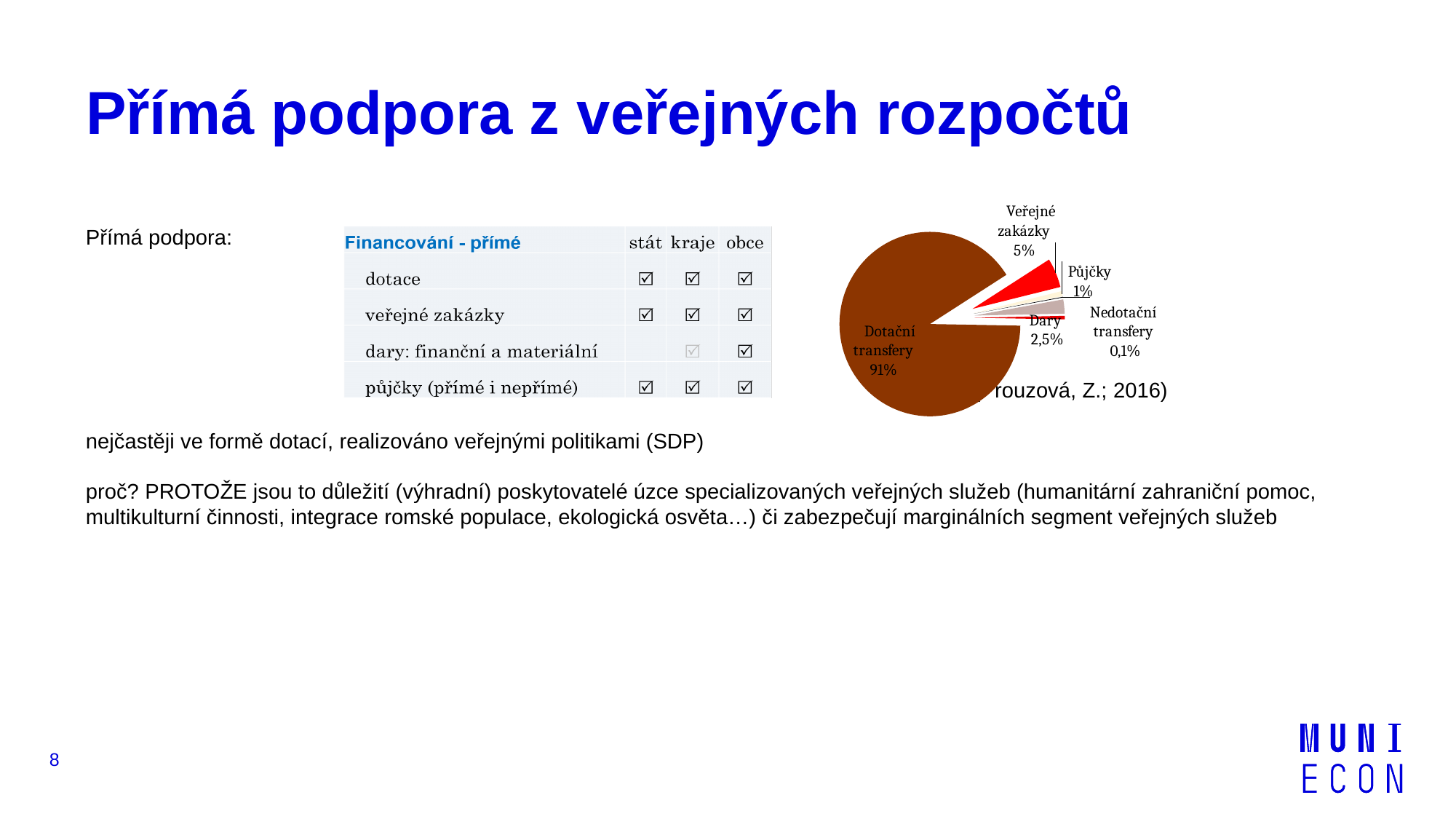
What share of the pie does Dary have? 2,5% Which slice of the pie chart is the largest? Dotační transfery What share of the pie does Veřejné zakázky have? 5% What kind of chart is shown on the slide? pie chart How many slices does the pie chart have? 6 What share of the pie does Dotační transfery have? 91% Which slice of the pie chart is the smallest? Nedotační transfery Which is larger in the pie chart, Dary or Půjčky? Dary What colour is the Dotační transfery slice in the pie chart? brown What is the difference in percentage points between Veřejné zakázky and Dary? 2,5%